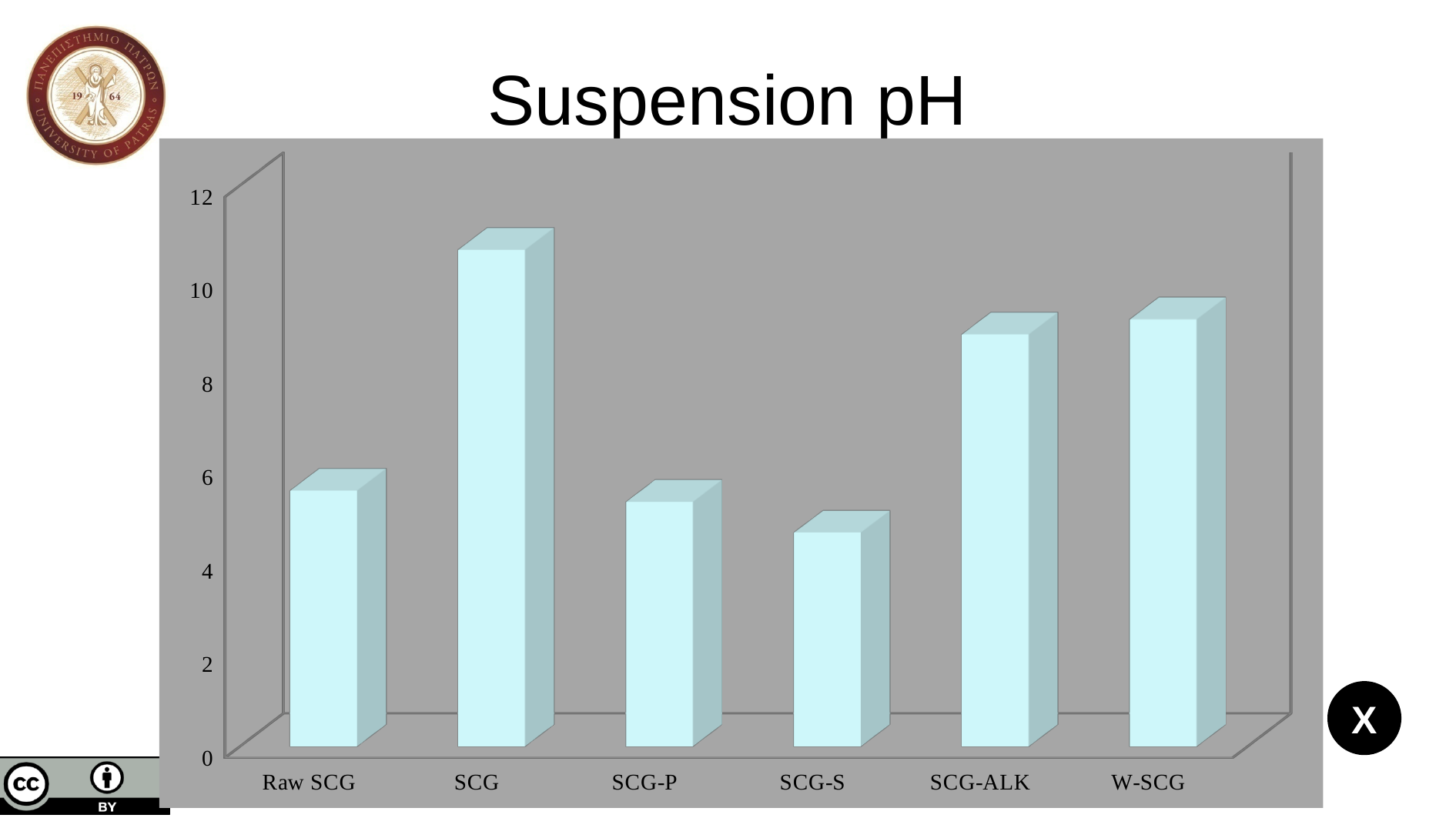
How many categories are shown on the x axis of the chart? 6 Which category has the lowest suspension pH? SCG-S What is the title of the chart? Suspension pH Which has a higher suspension pH, SCG or Raw SCG? SCG Which has a higher suspension pH, Raw SCG or SCG-S? Raw SCG Is the value for SCG-S greater or less than 6? less Which category has the highest suspension pH? SCG Is the value for SCG greater or less than 10? greater Is the value for SCG-ALK greater or less than 8? greater What kind of chart is shown on the slide? bar chart